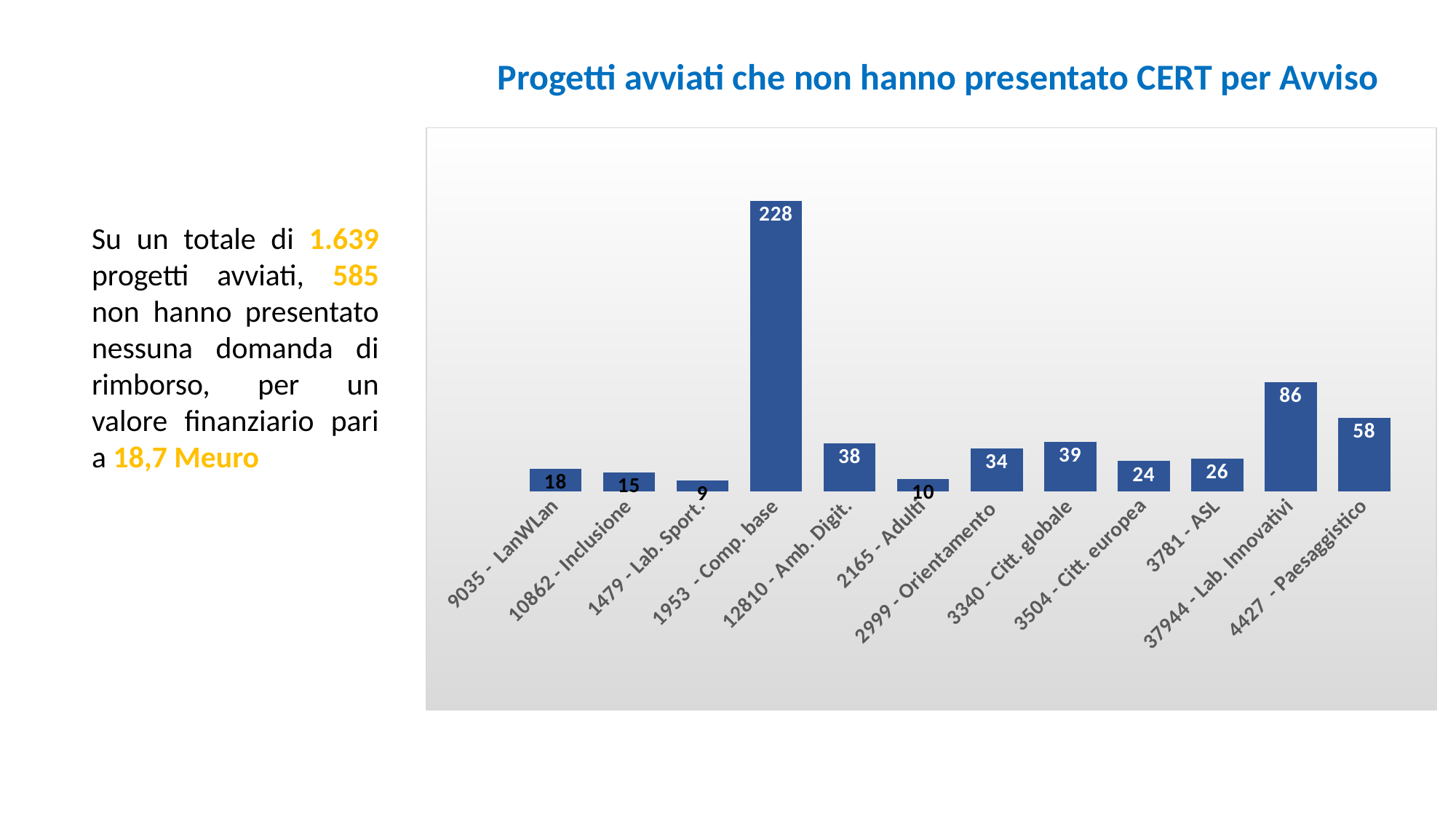
What is the difference between the values for 4427 - Paesaggistico and 12810 - Amb. Digit.? 20 What is the value for 3504 - Citt. europea? 24 What is the value for 2165 - Adulti? 10 What is the difference between the values for 1953 - Comp. base and 37944 - Lab. Innovativi? 142 Which is larger, the value for 3340 - Citt. globale or the value for 3781 - ASL? 3340 - Citt. globale What is the value for 37944 - Lab. Innovativi? 86 How many categories are shown on the x axis? 12 What kind of chart is shown on the slide? bar chart What is the title of the chart? Progetti avviati che non hanno presentato CERT per Avviso Which category has the highest value? 1953 - Comp. base Which category has the lowest value? 1479 - Lab. Sport. What is the value for 1953 - Comp. base? 228